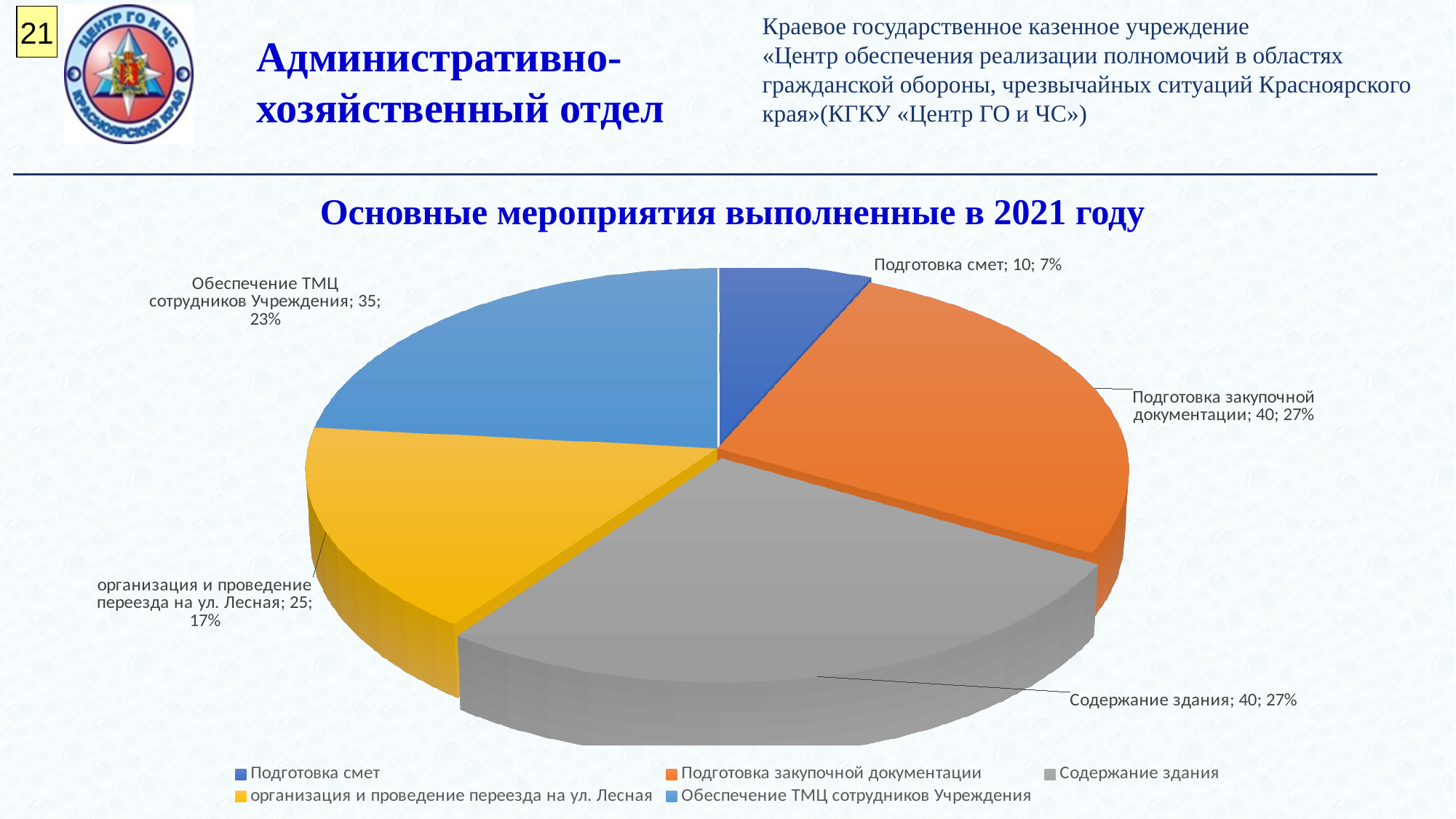
How many entries does the legend list? 5 What type of chart is shown on the slide? pie chart What percentage share does "Содержание здания" have? 27% What colour is the slice for "Содержание здания"? grey What is the value for "организация и проведение переезда на ул. Лесная"? 25 Which is larger: "Обеспечение ТМЦ сотрудников Учреждения" or "организация и проведение переезда на ул. Лесная"? Обеспечение ТМЦ сотрудников Учреждения What is the value for "Подготовка смет"? 10 Which category has the smallest slice? Подготовка смет What is the difference between the values for "Подготовка закупочной документации" and "Подготовка смет"? 30 What is the title of the chart? Основные мероприятия выполненные в 2021 году What percentage share does "Обеспечение ТМЦ сотрудников Учреждения" have? 23% How many slices does the pie chart have? 5